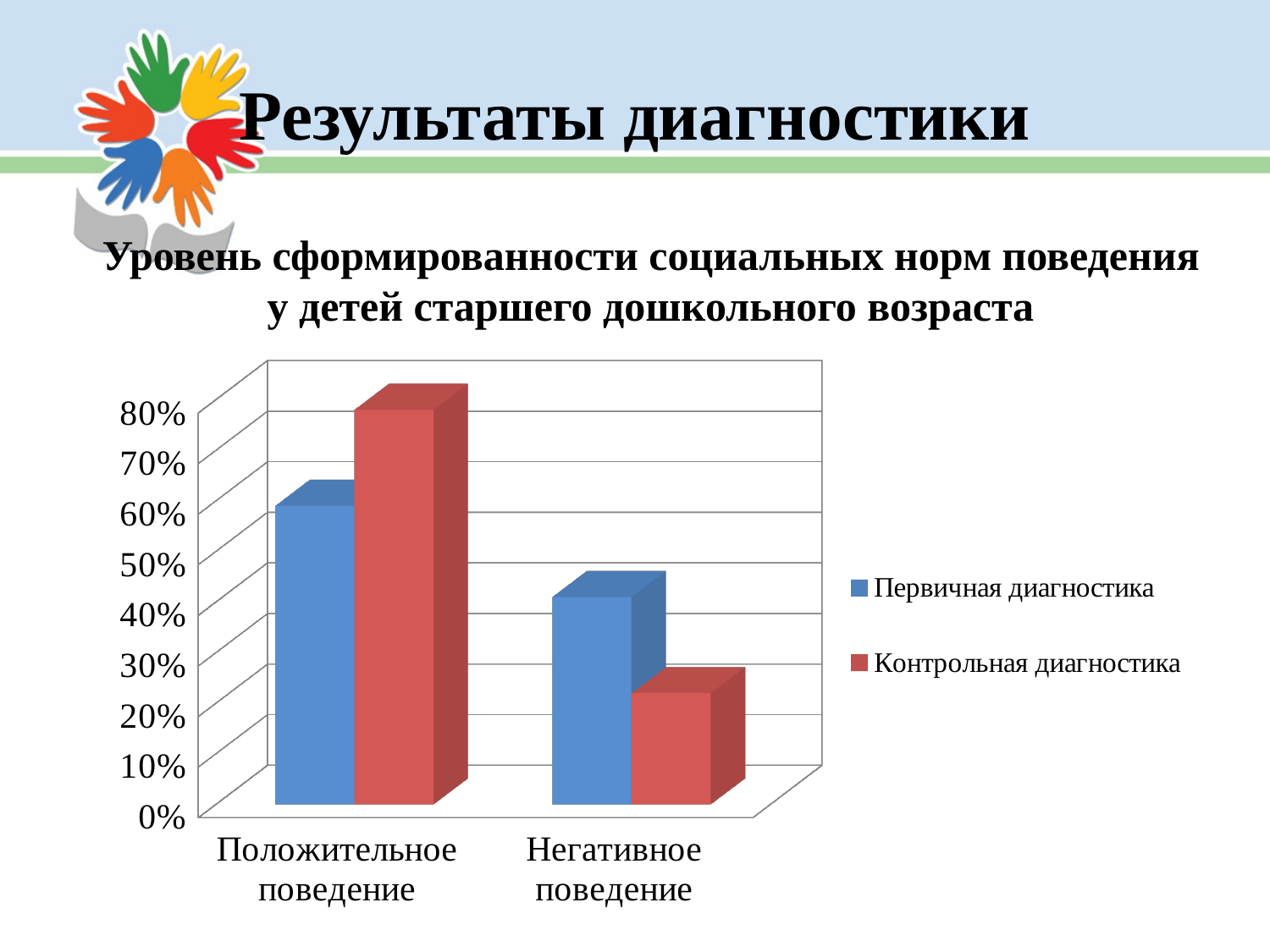
Is the value for Первичная диагностика in Положительное поведение greater or less than 50%? greater What is the title of the chart? Уровень сформированности социальных норм поведения у детей старшего дошкольного возраста Is the value for Контрольная диагностика in Положительное поведение greater or less than 70%? greater Is the value for Контрольная диагностика in Негативное поведение greater or less than 30%? less For Положительное поведение, which series has the larger value: Первичная диагностика or Контрольная диагностика? Контрольная диагностика For Негативное поведение, which series has the larger value: Первичная диагностика or Контрольная диагностика? Первичная диагностика How many series does the chart legend list? 2 Which series is shown in red in the chart? Контрольная диагностика What kind of chart is shown on the slide? bar chart How many categories are shown on the x axis of the chart? 2 Which category has the highest value for Контрольная диагностика? Положительное поведение